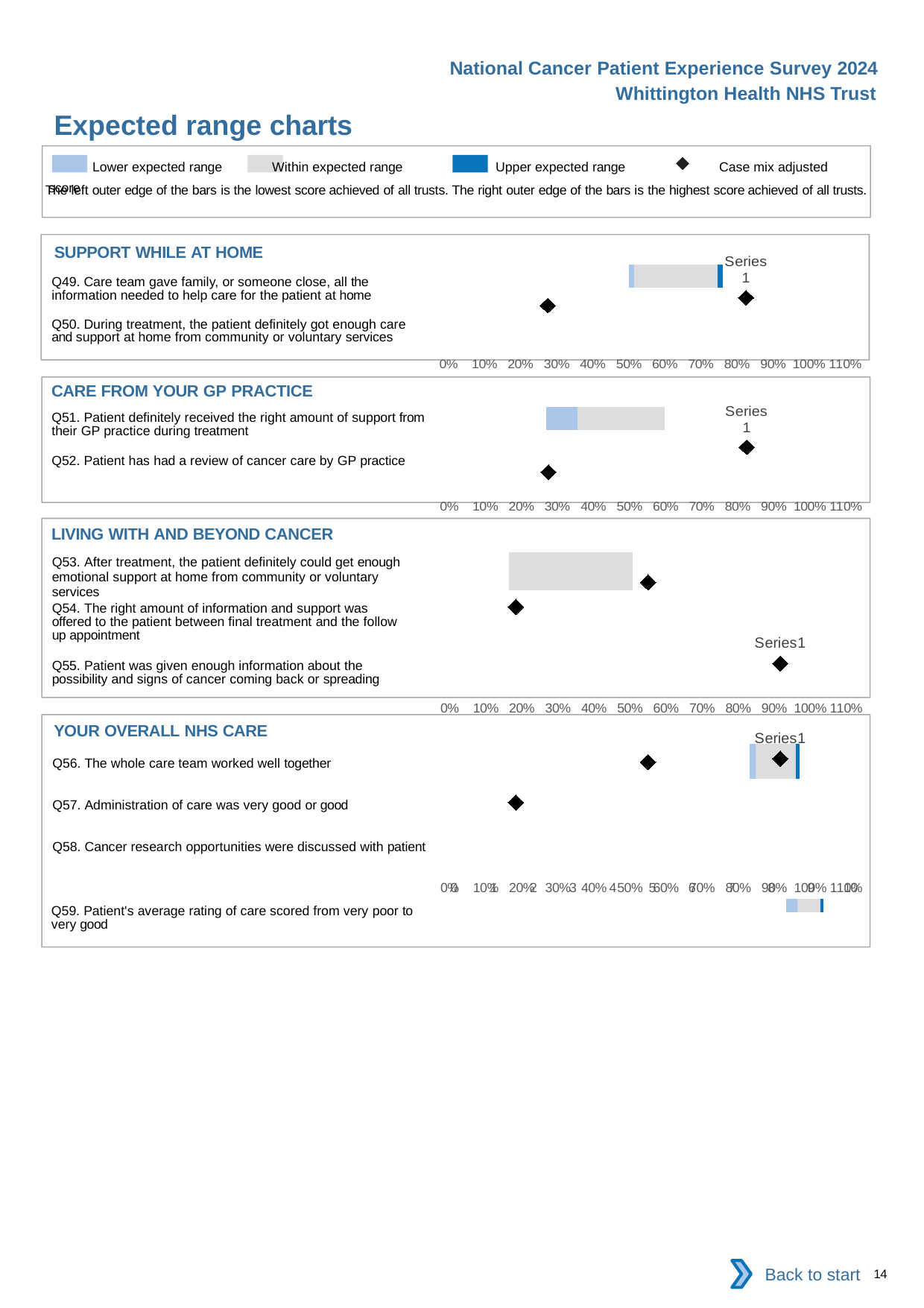
In the SUPPORT WHILE AT HOME chart, is the leftmost diamond marker greater or less than 40%? less How many question rows are listed in the LIVING WITH AND BEYOND CANCER chart? 3 How many question rows are listed in the YOUR OVERALL NHS CARE chart? 4 In the SUPPORT WHILE AT HOME chart, is the rightmost diamond marker greater or less than 70%? greater What is the title of the first chart section on the slide? SUPPORT WHILE AT HOME How many diamond markers are plotted in the SUPPORT WHILE AT HOME chart? 2 What is the highest percentage tick shown on the x axis of the CARE FROM YOUR GP PRACTICE chart? 110% In the CARE FROM YOUR GP PRACTICE chart, is the rightmost diamond marker greater or less than 70%? greater How many entries does the legend at the top of the slide list? 4 In the legend at the top of the slide, what does the black diamond marker represent? Case mix adjusted score